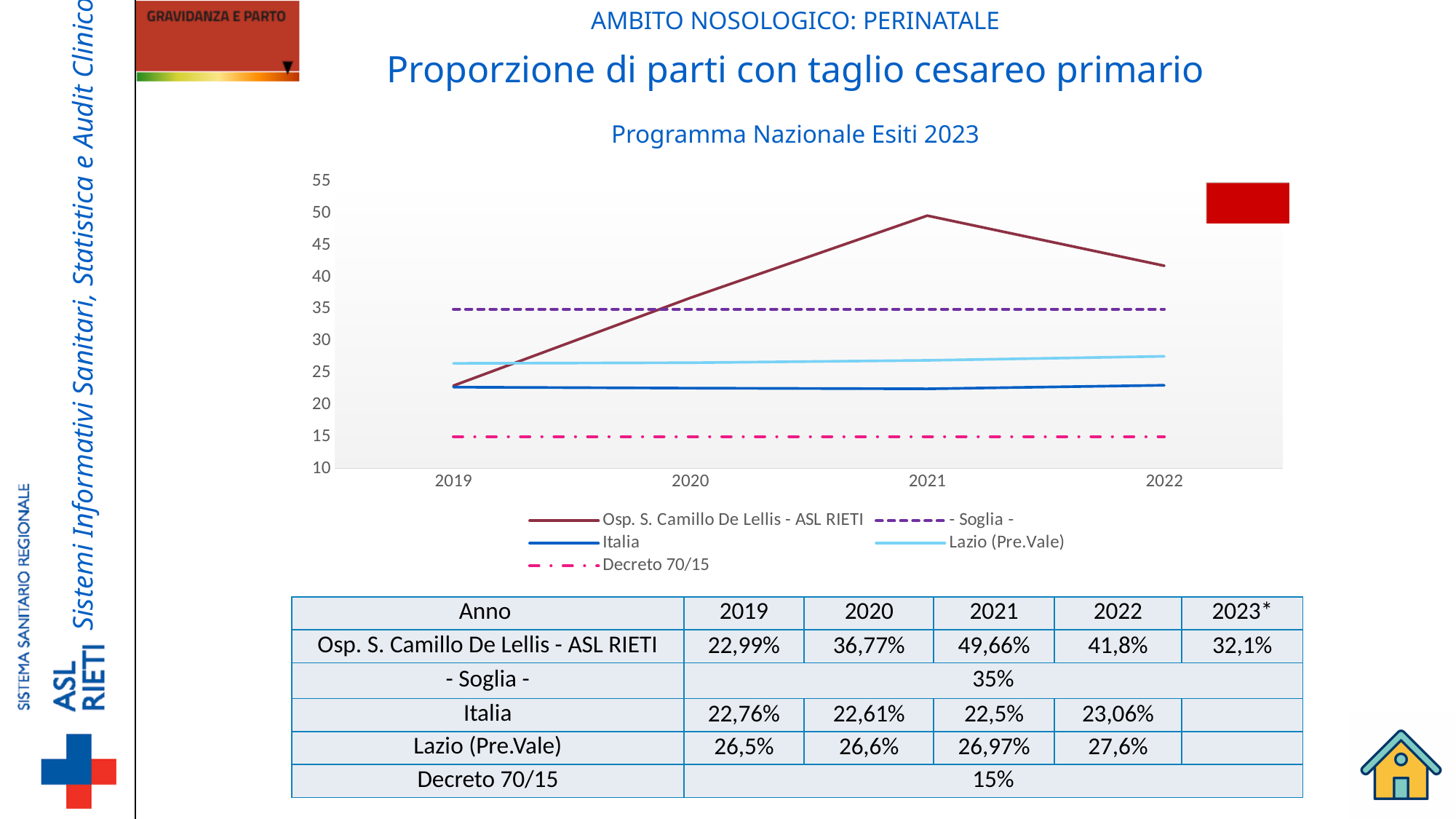
In which year does Osp. S. Camillo De Lellis - ASL RIETI reach its highest value? 2021 What is the value for Lazio (Pre.Vale) in 2022? 27,6% How many series does the chart legend list? 5 What constant value does the Decreto 70/15 line represent? 15% In which year does Osp. S. Camillo De Lellis - ASL RIETI have its lowest value? 2019 How many years are shown on the x axis of the chart? 4 In 2020, which is larger: the value for Osp. S. Camillo De Lellis - ASL RIETI or the - Soglia - value? Osp. S. Camillo De Lellis - ASL RIETI Does the Lazio (Pre.Vale) line rise or fall from 2019 to 2022? rise What is the value for Osp. S. Camillo De Lellis - ASL RIETI in 2021? 49,66% What is the difference between the Osp. S. Camillo De Lellis - ASL RIETI values in 2021 and 2022? 7,86% What constant value does the - Soglia - line represent? 35% What kind of chart is shown on the slide? line chart